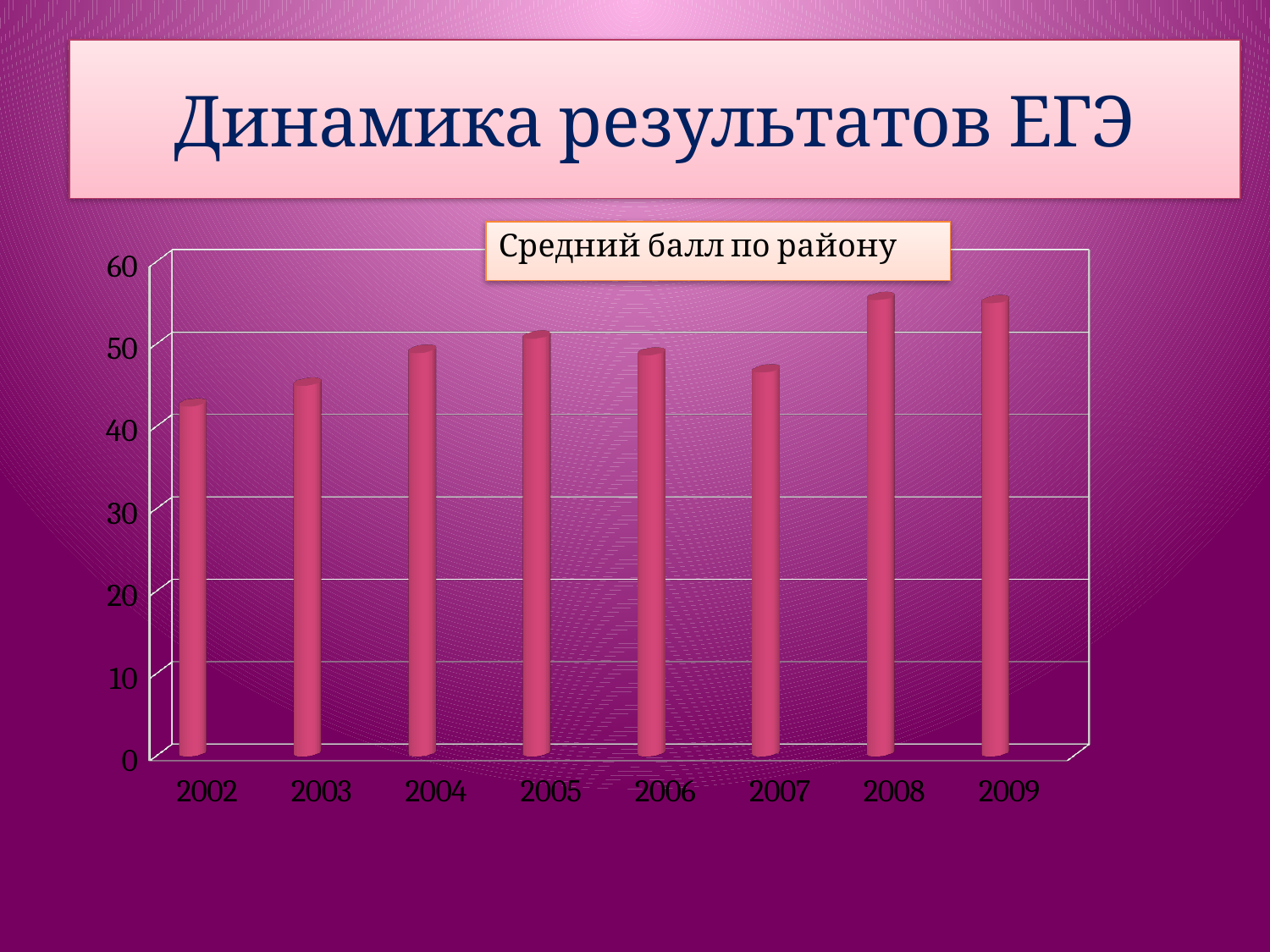
What kind of chart is shown on the slide? bar chart Do the values rise or fall from 2002 to 2005? rise Is the value for 2007 greater or less than 50? less Which is larger, the value for 2005 or the value for 2007? 2005 Is the value for 2003 greater or less than 50? less Which year has the lowest value in the chart? 2002 How many years are shown on the x axis of the chart? 8 Is the value for 2002 greater or less than 40? greater Which is larger, the value for 2008 or the value for 2002? 2008